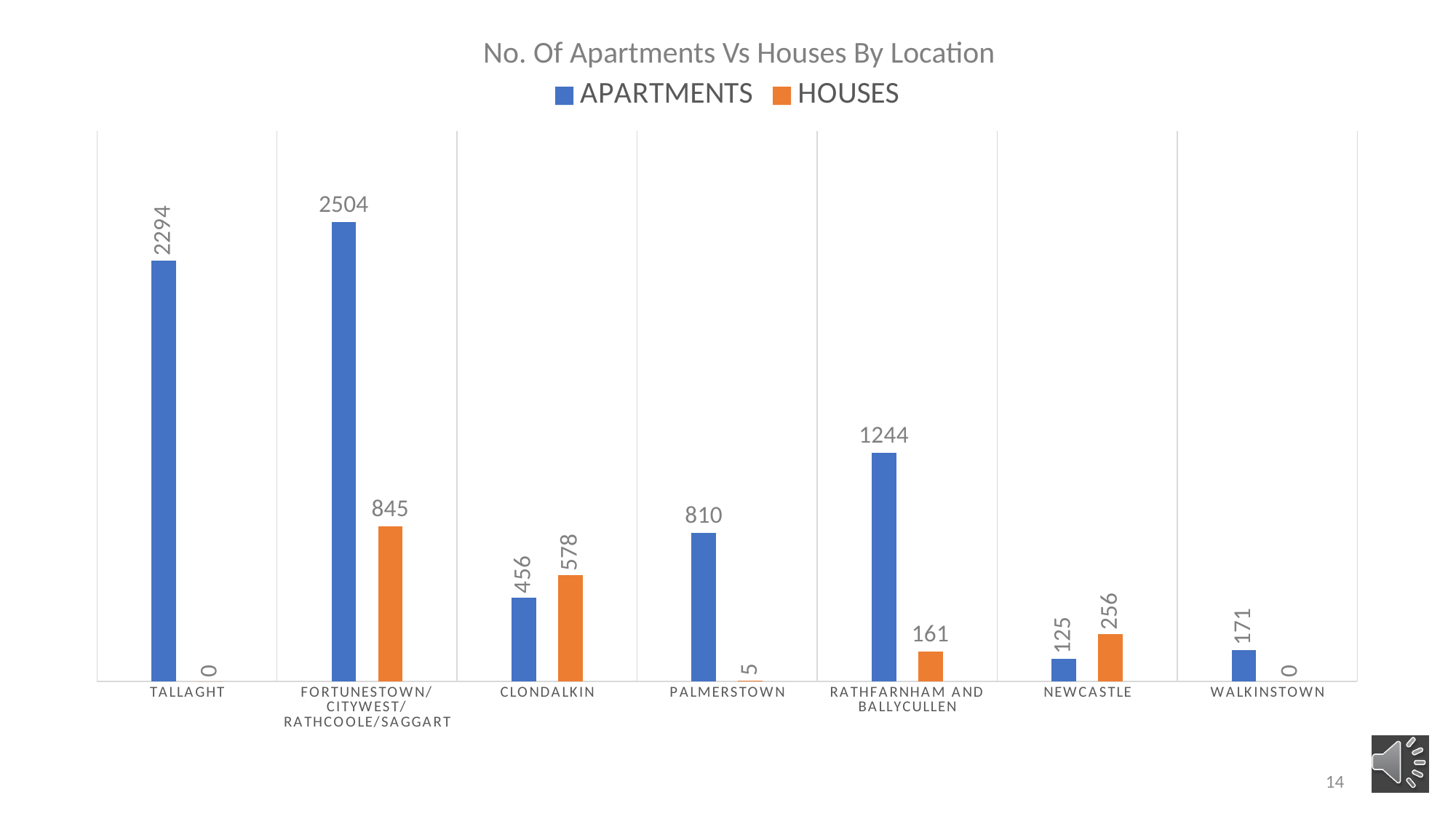
Which location has the lowest number of apartments? Newcastle How many series does the legend list? 2 What is the title of the chart? No. Of Apartments Vs Houses By Location Which is larger in Rathfarnham and Ballycullen, the number of apartments or the number of houses? Apartments What is the number of apartments in Tallaght? 2294 What is the number of houses in Fortunestown/Citywest/Rathcoole/Saggart? 845 What is the total number of apartments and houses in Palmerstown? 815 What is the number of houses in Newcastle? 256 Which location has the highest number of apartments? Fortunestown/Citywest/Rathcoole/Saggart What kind of chart is shown on the slide? Bar chart How many locations are shown on the chart? 7 What is the difference between the number of apartments and houses in Clondalkin? 122